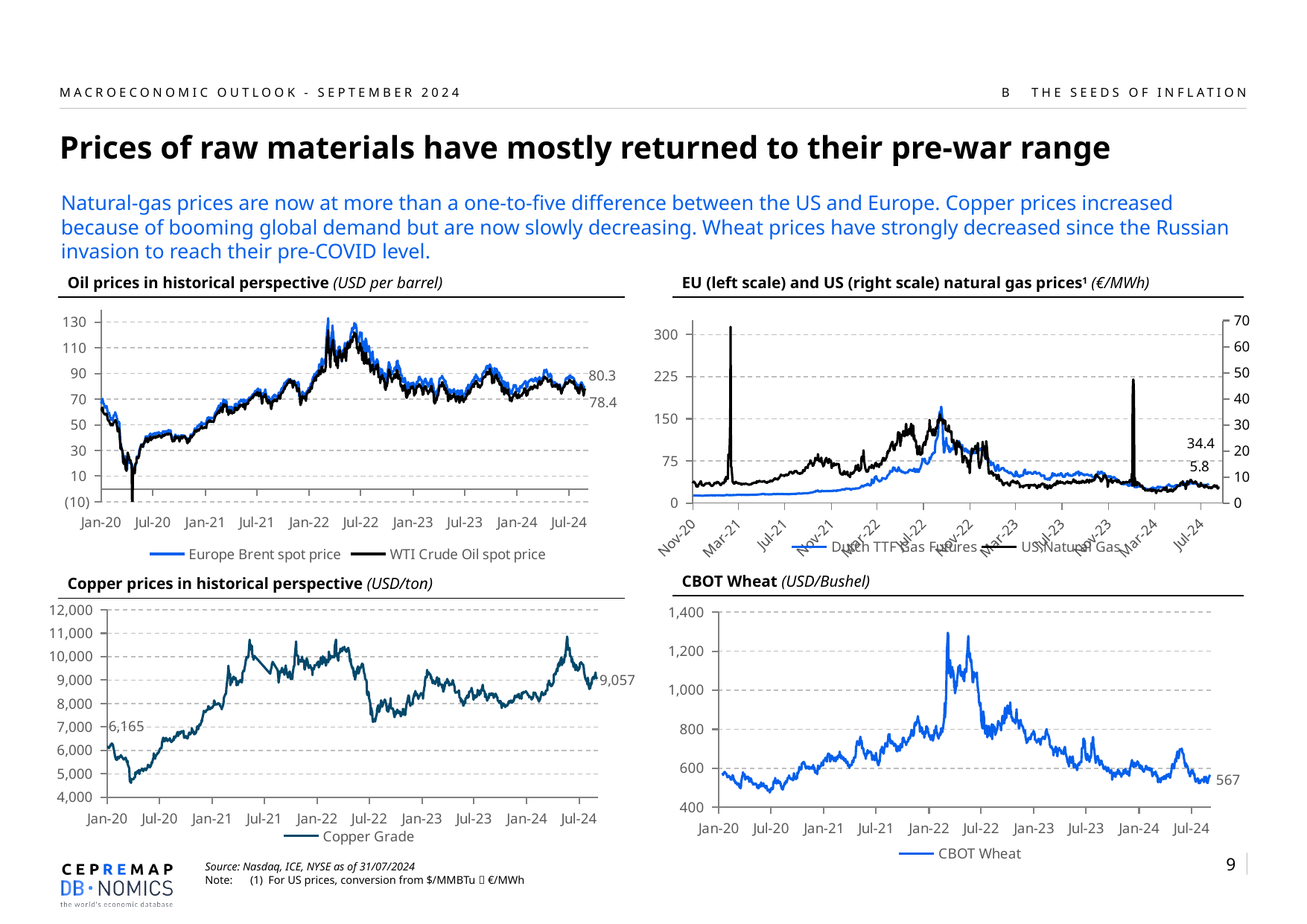
In the 'Oil prices in historical perspective' chart, what is the latest value shown for the WTI Crude Oil spot price? 78.4 In the 'Oil prices in historical perspective' chart, what is the difference between the latest Europe Brent value and the latest WTI Crude Oil value? 1.9 In the 'CBOT Wheat' chart, what is the latest value labelled at the end of the series? 567 In the 'Copper prices in historical perspective' chart, what is the difference between the end value (9,057) and the start value (6,165)? 2,892 In the 'EU (left scale) and US (right scale) natural gas prices' chart, what is the latest value shown for Dutch TTF Gas Futures? 34.4 What kind of chart is the 'CBOT Wheat' chart? line chart In the 'Copper prices in historical perspective' chart, what is the latest value labelled at the end of the series? 9,057 In the 'Oil prices in historical perspective' chart, what is the latest value shown for the Europe Brent spot price? 80.3 In the 'EU (left scale) and US (right scale) natural gas prices' chart, what is the latest value shown for US Natural Gas? 5.8 In the 'Oil prices in historical perspective' chart, how many series does the legend list? 2 In the 'CBOT Wheat' chart, is the peak value reached in 2022 greater or less than 1,200? greater In the 'Copper prices in historical perspective' chart, what is the value labelled at the start of the series in Jan-20? 6,165